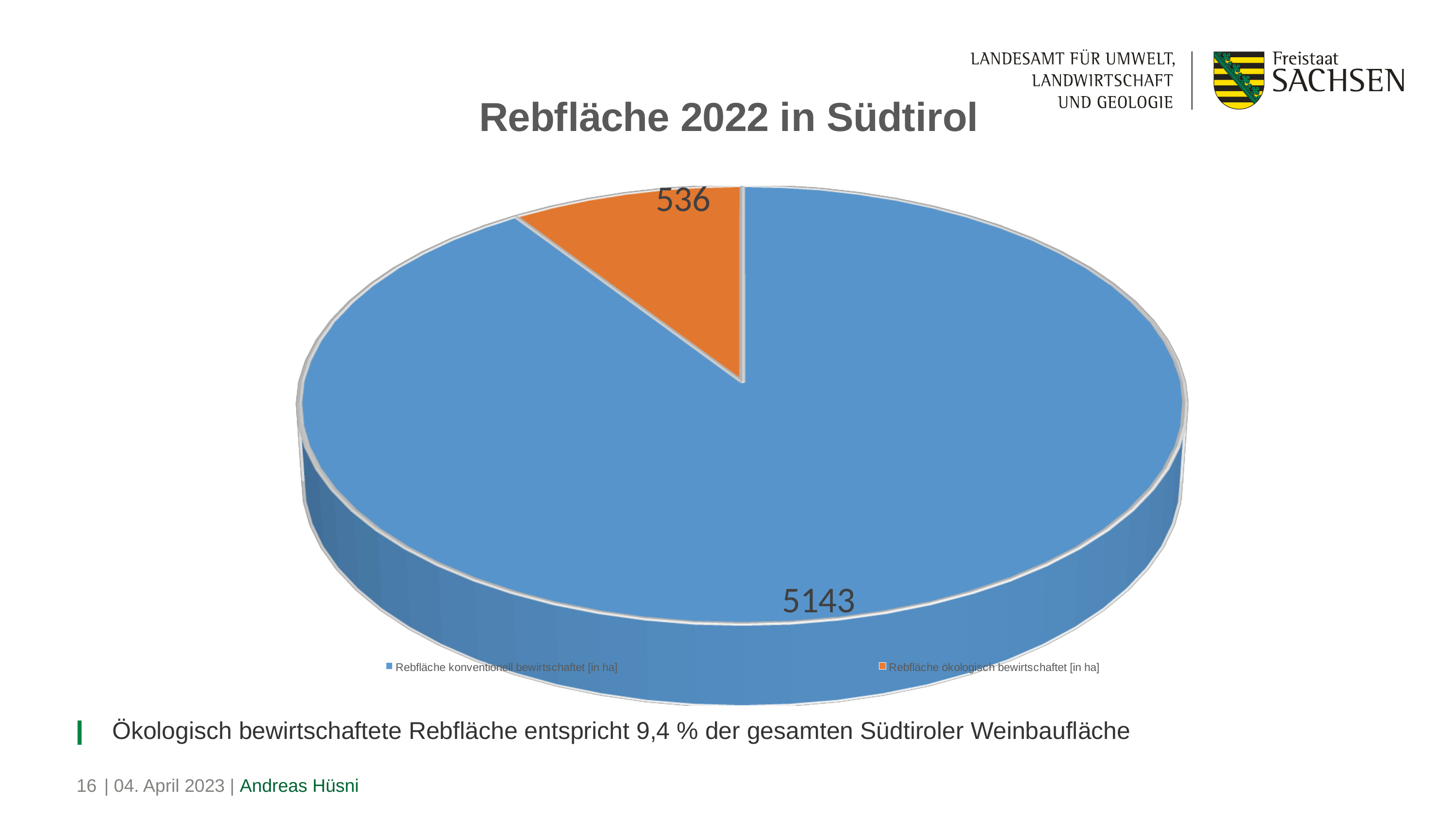
What is the value for Rebfläche konventionell bewirtschaftet [in ha]? 5143 What is the difference between the conventionally farmed and the organically farmed vineyard area? 4607 What is the title of the chart? Rebfläche 2022 in Südtirol What share of the total vineyard area is organically farmed, according to the slide? 9,4 % What kind of chart is shown on the slide? Pie chart Which category has the largest slice of the pie? Rebfläche konventionell bewirtschaftet [in ha] What is the total vineyard area represented by the pie chart? 5679 How many slices does the pie chart have? 2 Which is larger: the conventionally farmed area or the organically farmed area? Rebfläche konventionell bewirtschaftet [in ha] What is the value for Rebfläche ökologisch bewirtschaftet [in ha]? 536 Which category has the smallest slice of the pie? Rebfläche ökologisch bewirtschaftet [in ha] How many entries does the legend list? 2